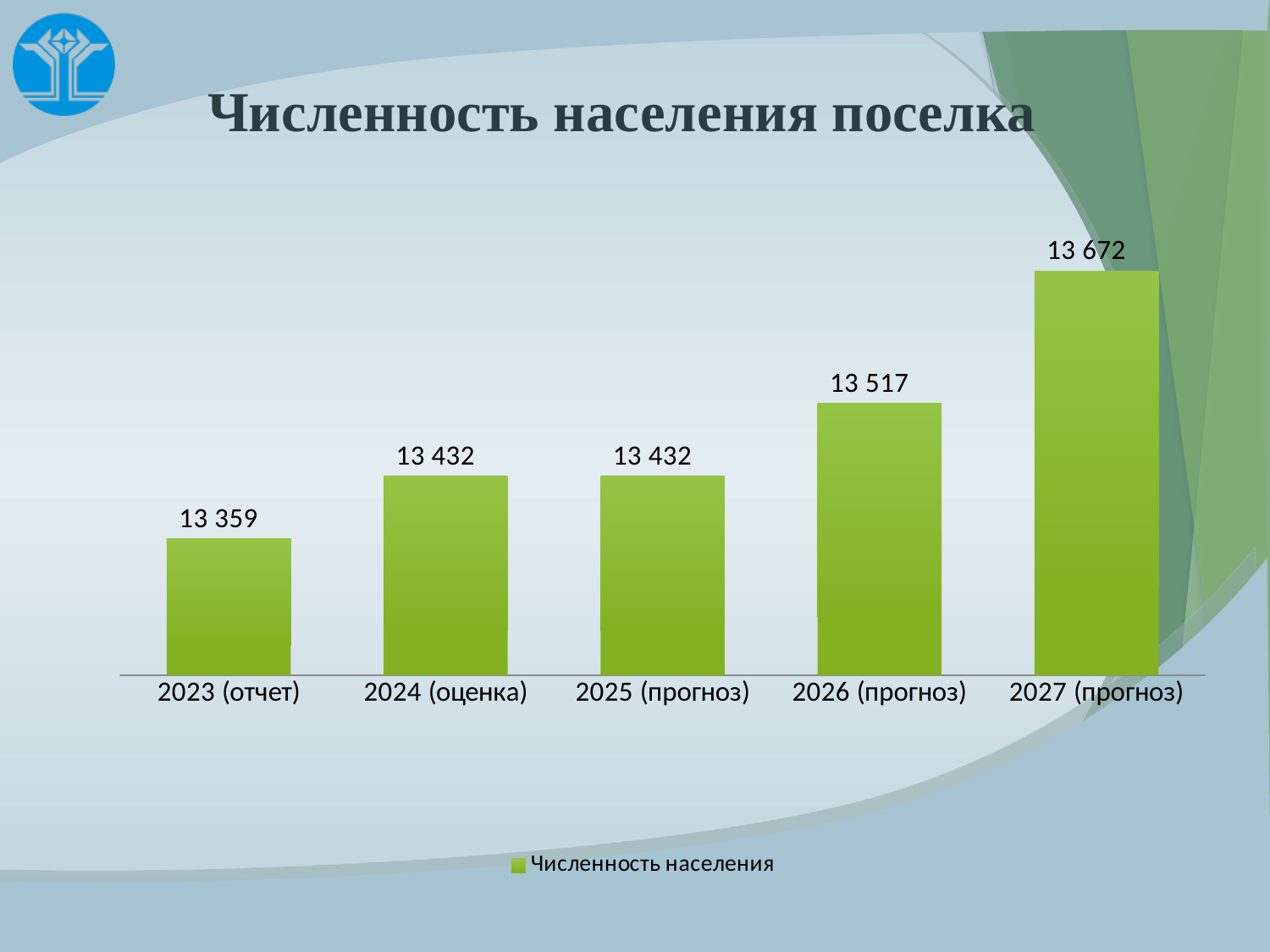
What is the population value for 2023 (отчет)? 13 359 What kind of chart is shown on the slide? bar chart What is the population value for 2027 (прогноз)? 13 672 What is the difference between the values for 2024 (оценка) and 2023 (отчет)? 73 Which year has the highest population value? 2027 (прогноз) How many series does the legend list? 1 What is the difference between the values for 2027 (прогноз) and 2026 (прогноз)? 155 Which year has the lowest population value? 2023 (отчет) What is the title of the chart? Численность населения поселка How many years (categories) are shown on the chart? 5 Which is larger, the value for 2025 (прогноз) or the value for 2026 (прогноз)? 2026 (прогноз) What is the population value for 2026 (прогноз)? 13 517